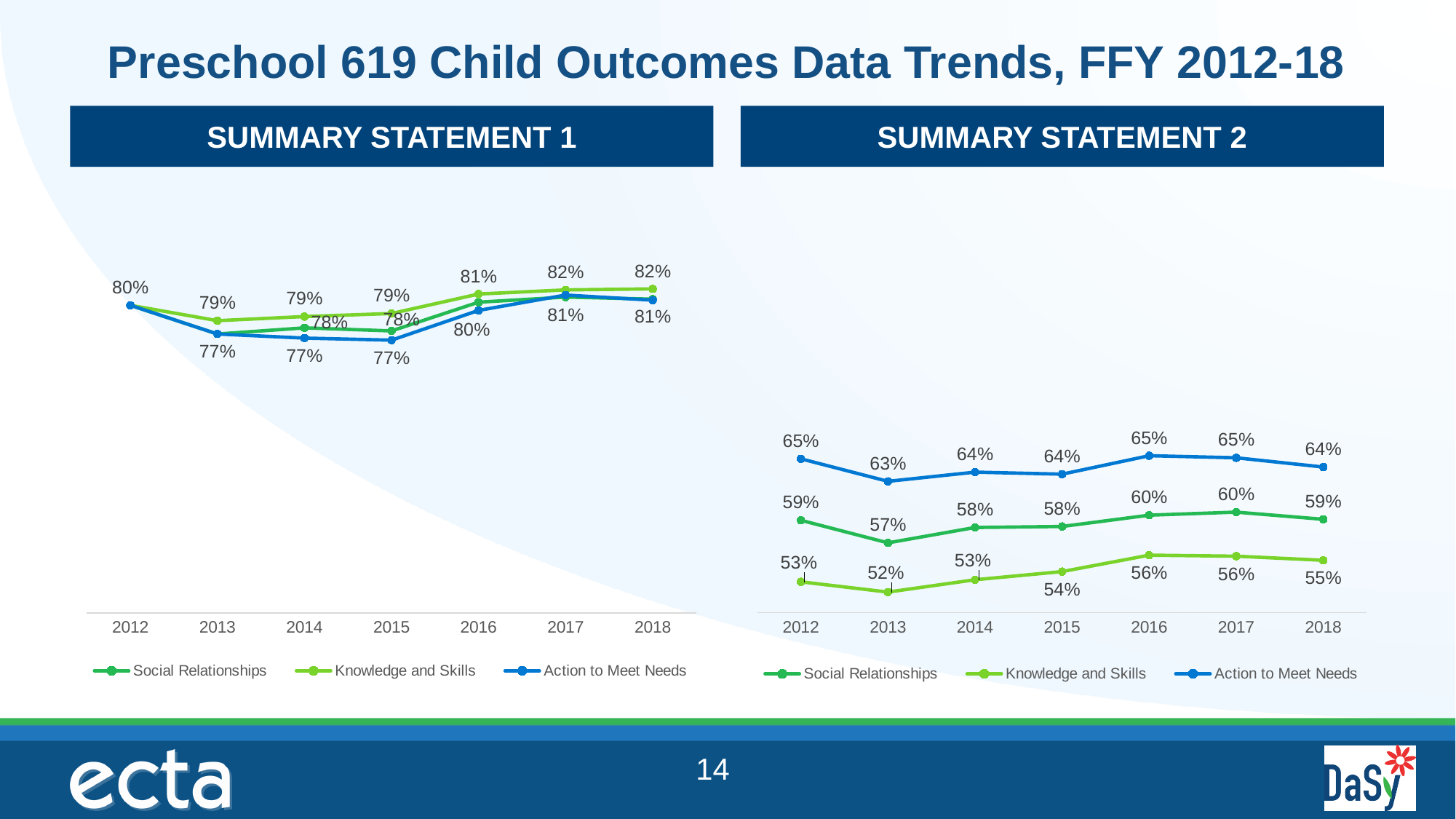
How many series does the legend of the Summary Statement 2 chart list? 3 In the Summary Statement 1 chart, does the Knowledge and Skills line rise or fall from 2015 to 2017? Rise In the Summary Statement 1 chart, what is the value for Knowledge and Skills in 2017? 82% How many years are shown on the x axis of the Summary Statement 1 chart? 7 In the Summary Statement 1 chart, is the Knowledge and Skills value larger in 2012 or in 2018? 2018 In the Summary Statement 2 chart, what is the value for Social Relationships in 2017? 60% In the Summary Statement 2 chart, what is the value for Knowledge and Skills in 2013? 52% In the Summary Statement 2 chart, what is the value for Action to Meet Needs in 2012? 65% What type of chart is used for Summary Statement 1? Line chart In the Summary Statement 2 chart, in which year is Knowledge and Skills at its lowest? 2013 In the Summary Statement 2 chart, what is the difference between Action to Meet Needs and Knowledge and Skills in 2018? 9 percentage points In the Summary Statement 2 chart, which series has the highest values across all years? Action to Meet Needs